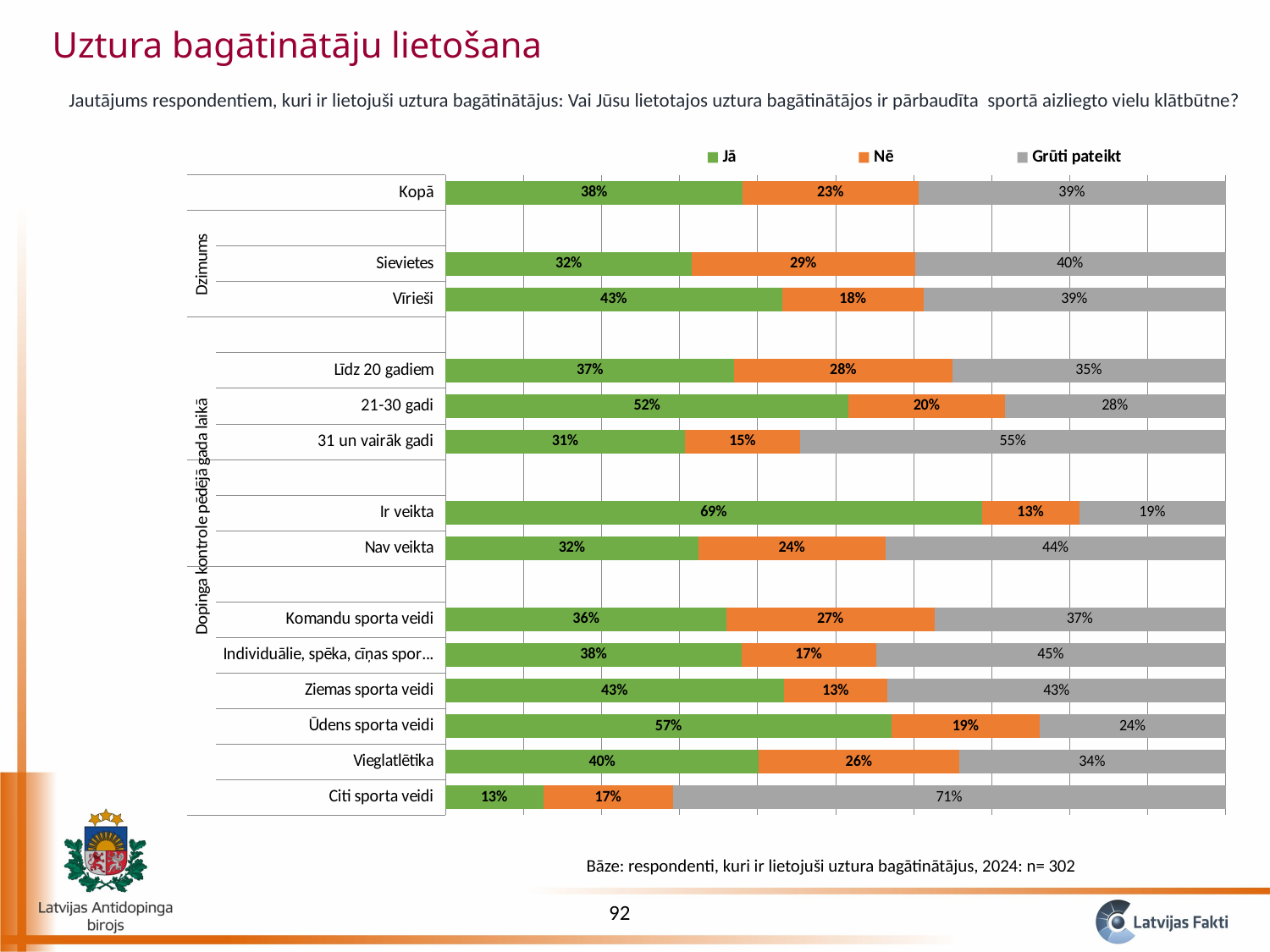
Which category has the highest "Jā" value? Ir veikta Which category has the lowest "Jā" value? Citi sporta veidi How many series does the legend list? 3 What is the "Nē" value for "Sievietes"? 29% How many categories (bars) are plotted in the chart? 14 Which colour represents the "Nē" series in the chart? Orange What kind of chart is shown on the slide? Stacked bar chart What is the difference between the "Jā" values for "Vīrieši" and "Sievietes"? 11% Which has a larger "Nē" value, "Līdz 20 gadiem" or "31 un vairāk gadi"? Līdz 20 gadiem What is the "Jā" value for "Ūdens sporta veidi"? 57% What percentage of respondents in the "Kopā" category answered "Jā"? 38% What is the "Grūti pateikt" value for "Citi sporta veidi"? 71%